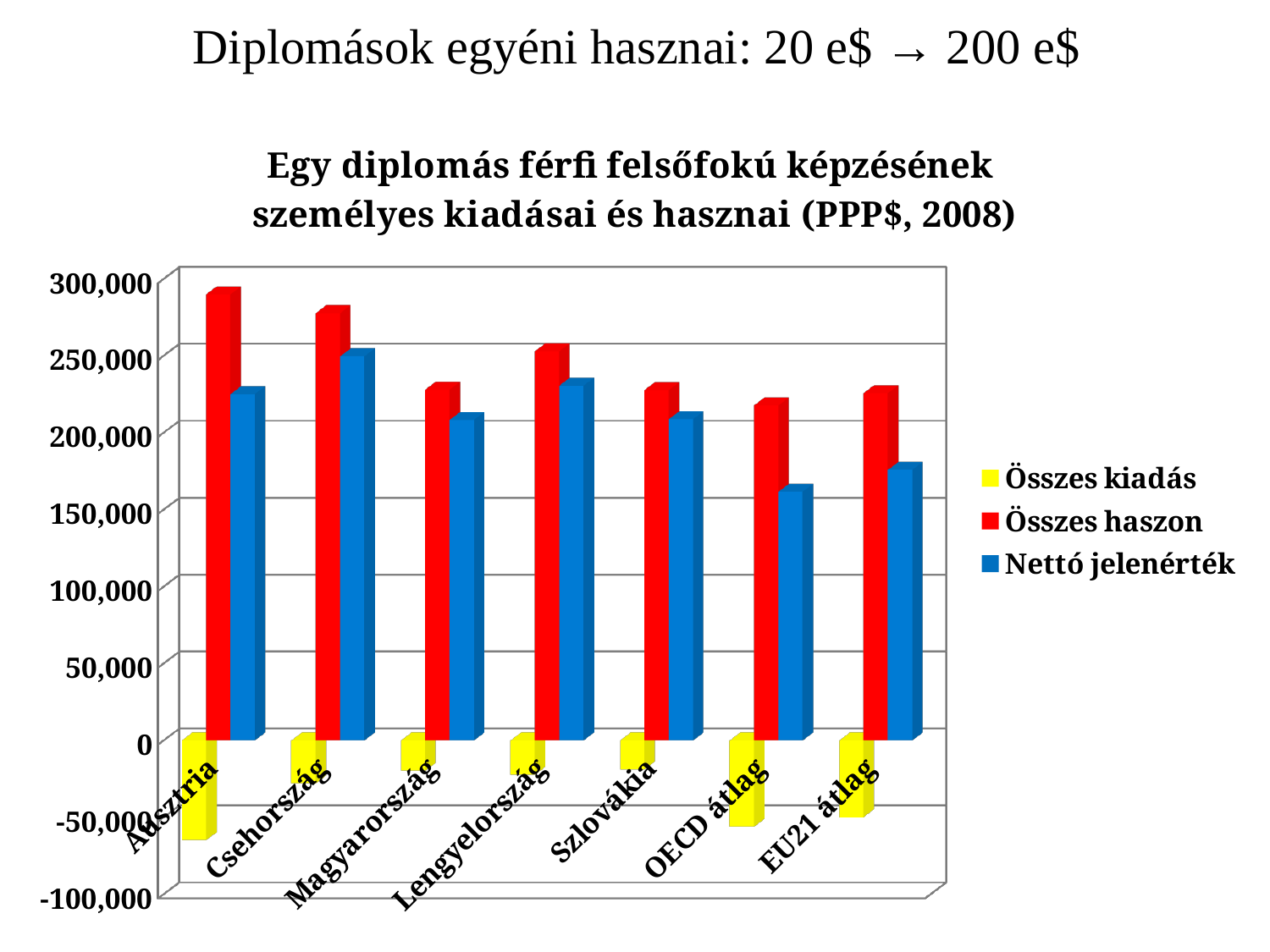
Which category has the highest value for Összes haszon? Ausztria Which category has the highest value for Nettó jelenérték? Csehország Which category has the lowest value for Nettó jelenérték? OECD átlag Which is larger, the Nettó jelenérték for Csehország or for EU21 átlag? Csehország Is the Nettó jelenérték value for OECD átlag greater or less than 200,000? less How many series does the legend list? 3 How many categories are shown on the x axis of the chart? 7 Is the Összes haszon value for Ausztria greater or less than 250,000? greater Is the Összes kiadás value for Ausztria greater or less than -50,000? less Which series is shown in yellow in the legend? Összes kiadás Which is larger, the Összes haszon for Lengyelország or for Magyarország? Lengyelország What kind of chart is shown on the slide? bar chart